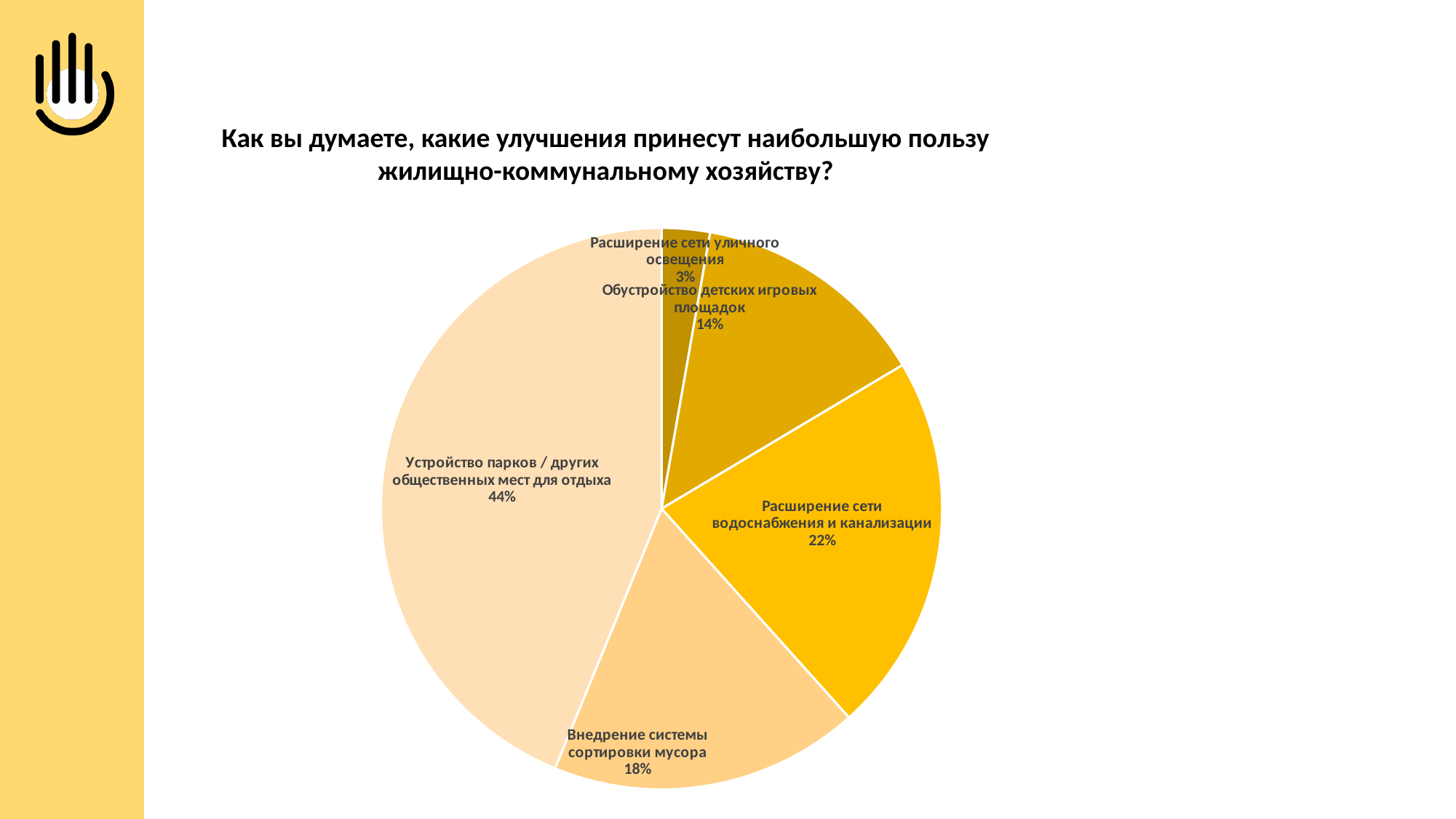
Which category has the largest share of the pie? Устройство парков / других общественных мест для отдыха What is the value for "Расширение сети водоснабжения и канализации"? 22% How many categories (slices) does the pie chart have? 5 Which category has the smallest share of the pie? Расширение сети уличного освещения What share of the pie does "Устройство парков / других общественных мест для отдыха" have? 44% What is the value for "Внедрение системы сортировки мусора"? 18% Which is larger: the share for "Обустройство детских игровых площадок" or for "Внедрение системы сортировки мусора"? Внедрение системы сортировки мусора What is the value for "Обустройство детских игровых площадок"? 14% What is the value for "Расширение сети уличного освещения"? 3% What is the difference between the shares for "Расширение сети водоснабжения и канализации" and "Внедрение системы сортировки мусора"? 4% What kind of chart is shown on the slide? pie chart What is the title of the chart? Как вы думаете, какие улучшения принесут наибольшую пользу жилищно-коммунальному хозяйству?